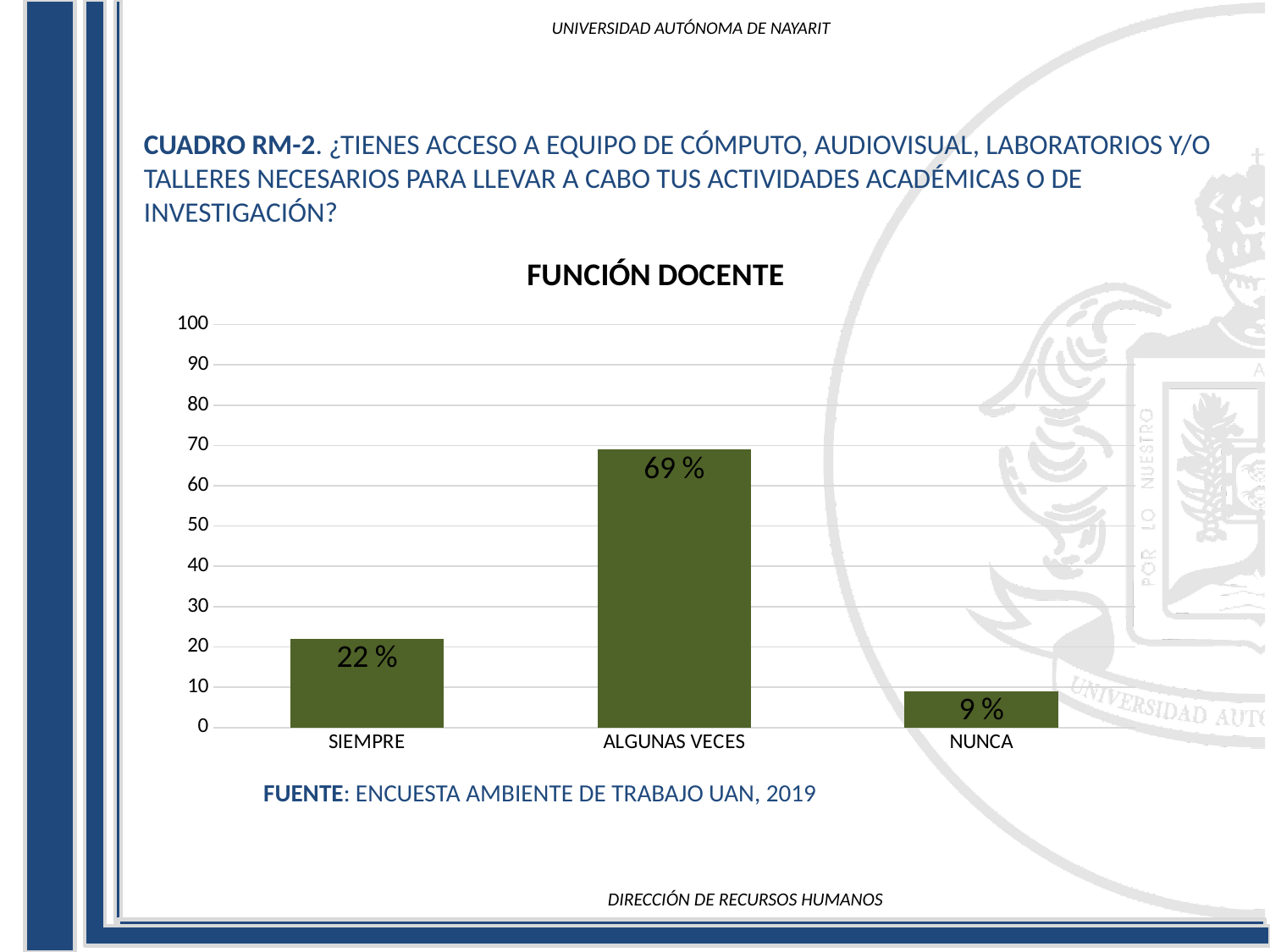
What is the title of the chart? FUNCIÓN DOCENTE Which category has the highest value? ALGUNAS VECES How many categories are shown on the x axis? 3 Is the value for ALGUNAS VECES greater or less than 60? greater What is the value for ALGUNAS VECES? 69 % What is the value for NUNCA? 9 % What is the difference between the values for ALGUNAS VECES and SIEMPRE? 47 % Which category has the lowest value? NUNCA Which is larger, the value for SIEMPRE or the value for NUNCA? SIEMPRE What is the value for SIEMPRE? 22 % What is the difference between the values for SIEMPRE and NUNCA? 13 % What kind of chart is shown on the slide? bar chart